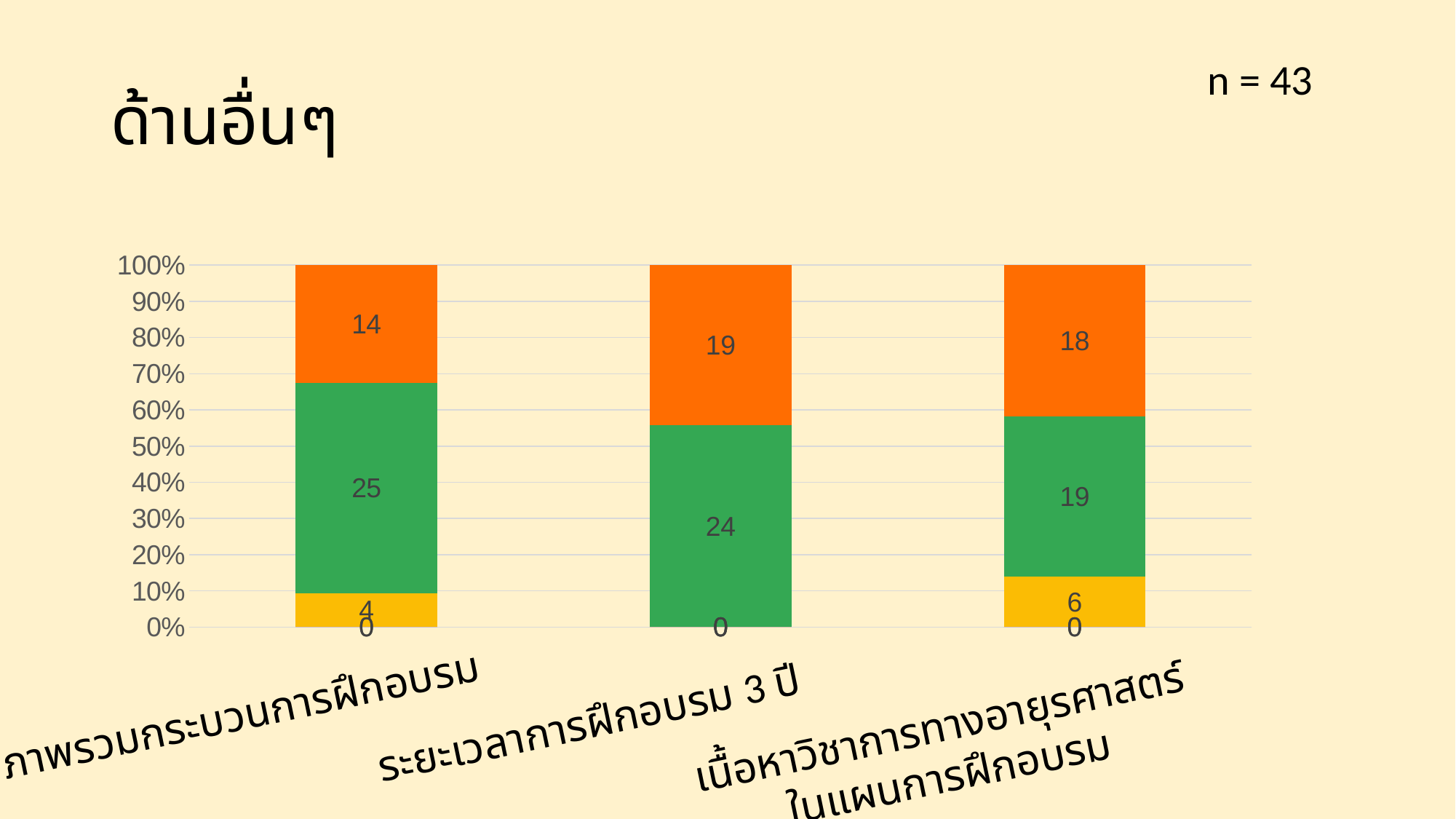
What is the value of the orange segment for ภาพรวมกระบวนการฝึกอบรม? 14 What is the sample size (n) stated on the slide? n = 43 What kind of chart is shown on the slide? Stacked bar chart What is the value of the yellow segment for ภาพรวมกระบวนการฝึกอบรม? 4 Is the orange segment value for ระยะเวลาการฝึกอบรม 3 ปี larger or smaller than the orange segment value for เนื้อหาวิชาการทางอายุรศาสตร์ในแผนการฝึกอบรม? larger What is the value of the green segment for ระยะเวลาการฝึกอบรม 3 ปี? 24 Which category has the highest value in the orange segment? ระยะเวลาการฝึกอบรม 3 ปี What is the title of the slide containing the chart? ด้านอื่นๆ How many categories are shown on the x axis of the chart? 3 What is the value of the yellow segment for เนื้อหาวิชาการทางอายุรศาสตร์ในแผนการฝึกอบรม? 6 What is the difference between the green segment values for ภาพรวมกระบวนการฝึกอบรม and เนื้อหาวิชาการทางอายุรศาสตร์ในแผนการฝึกอบรม? 6 Which category has the lowest value in the green segment? เนื้อหาวิชาการทางอายุรศาสตร์ในแผนการฝึกอบรม